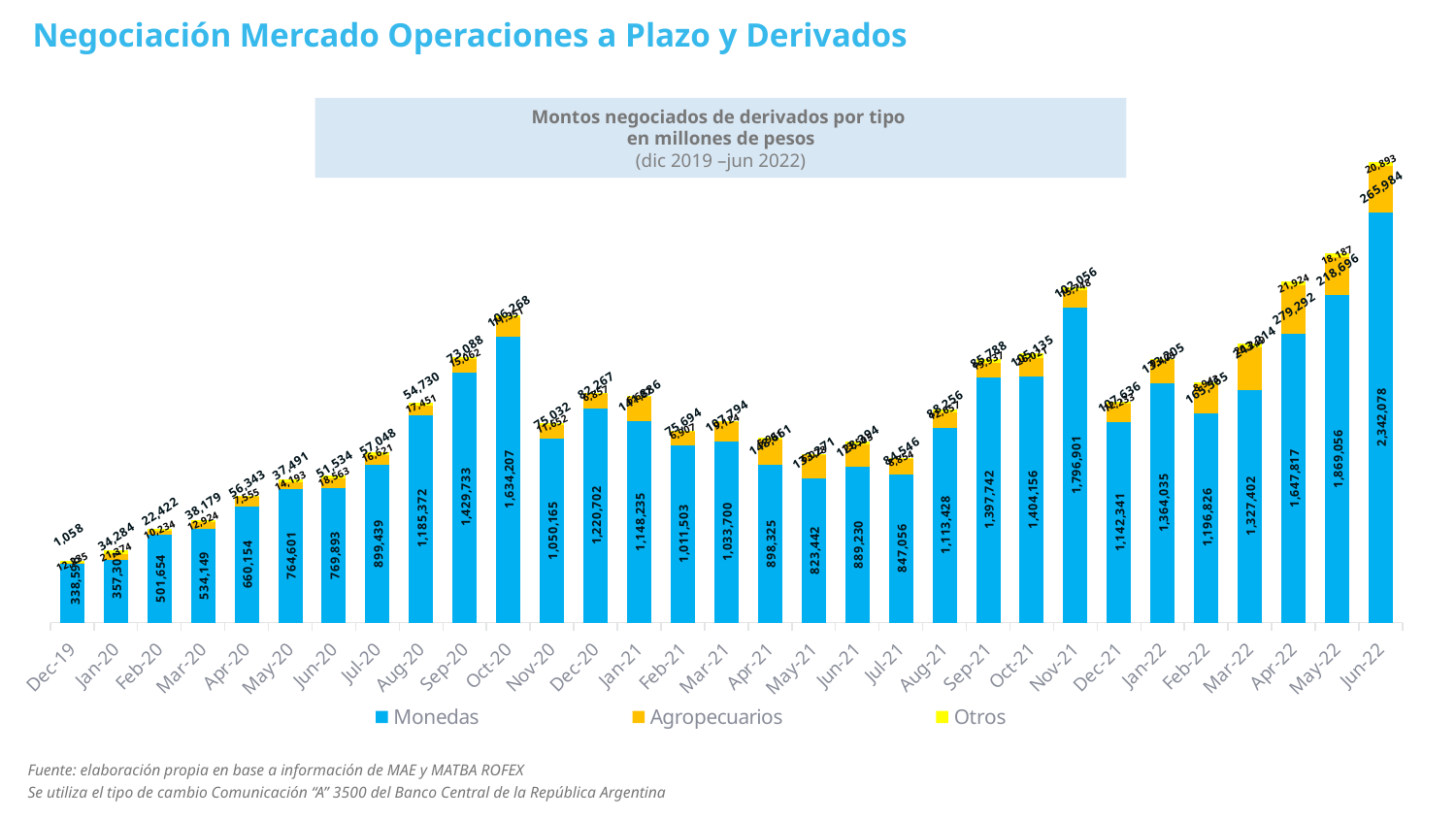
How many months are plotted along the x axis? 31 Which month has the highest Monedas value? Jun-22 What is the Monedas value for Jun-22? 2,342,078 What is the difference between the Monedas values for Jun-22 and May-22? 473,022 What kind of chart is shown on the slide? Stacked bar chart What is the Monedas value for Oct-20? 1,634,207 What is the total of the stacked bar for Jun-22 (Monedas + Agropecuarios + Otros)? 2,628,955 What is the Monedas value for Nov-21? 1,796,901 How many series does the legend list? 3 Which is larger, the Monedas value for Sep-20 or for Dec-20? Sep-20 What is the Agropecuarios value for Jun-22? 265,984 Which month has the lowest Monedas value? Dec-19